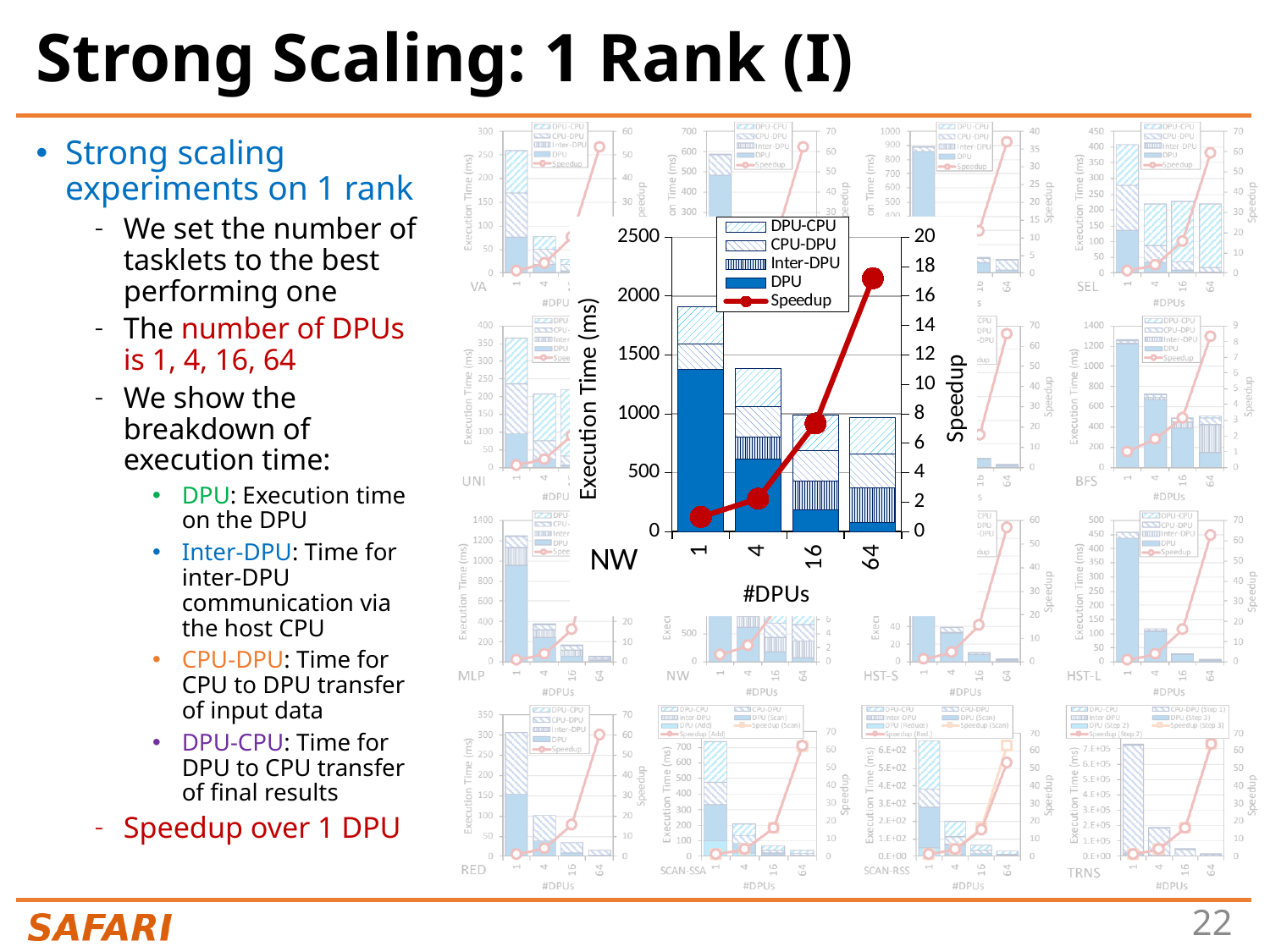
In the enlarged NW chart, is the total execution time for 4 DPUs greater or less than 1500 ms? less In the enlarged NW chart, is the Speedup for 64 DPUs greater or less than 10? greater In the enlarged NW chart, is the total execution time for 1 DPU greater or less than 1500 ms? greater In the enlarged NW chart, which #DPUs value has the highest total execution time? 1 In the enlarged NW chart, what is the label of the right-hand y axis? Speedup In the enlarged NW chart, how many #DPUs categories are shown on the x axis? 4 In the enlarged NW chart, which has the larger total execution time: 1 DPU or 4 DPUs? 1 DPU In the enlarged NW chart, what kind of chart is used to show the execution time breakdown? Stacked bar chart (with a line for Speedup) In the enlarged NW chart, which legend entry is plotted as a line rather than as bars? Speedup In the enlarged NW chart, how many entries does the legend list? 5 In the enlarged NW chart, does the Speedup line rise or fall as #DPUs increases from 1 to 64? Rises